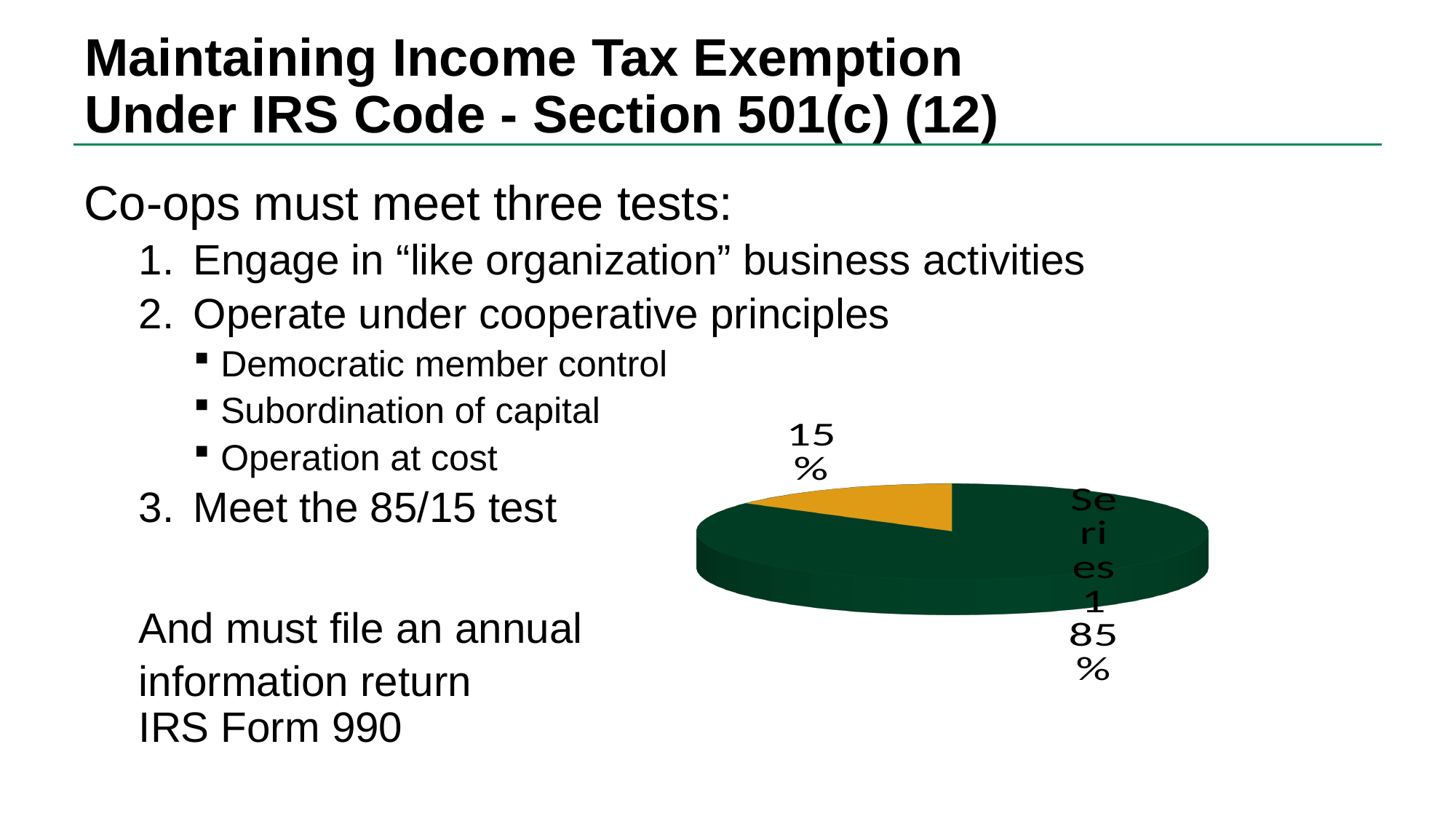
Which slice of the pie chart is the smallest? the orange slice (15%) What percentage is shown on the green slice of the pie chart? 85% Which slice of the pie chart is the largest? the green slice (85%) What percentage is shown on the orange slice of the pie chart? 15% How many slices does the pie chart have? 2 What label appears on the green slice of the pie chart besides its percentage? Series 1 What kind of chart is shown on the slide? pie chart What colour is the 15% slice of the pie chart? orange Do the two slices of the pie chart add up to 100%? yes What share of the pie does the slice labelled "Series 1" represent? 85% What is the difference in percentage points between the green slice and the orange slice? 70 Which is larger, the green slice or the orange slice? the green slice